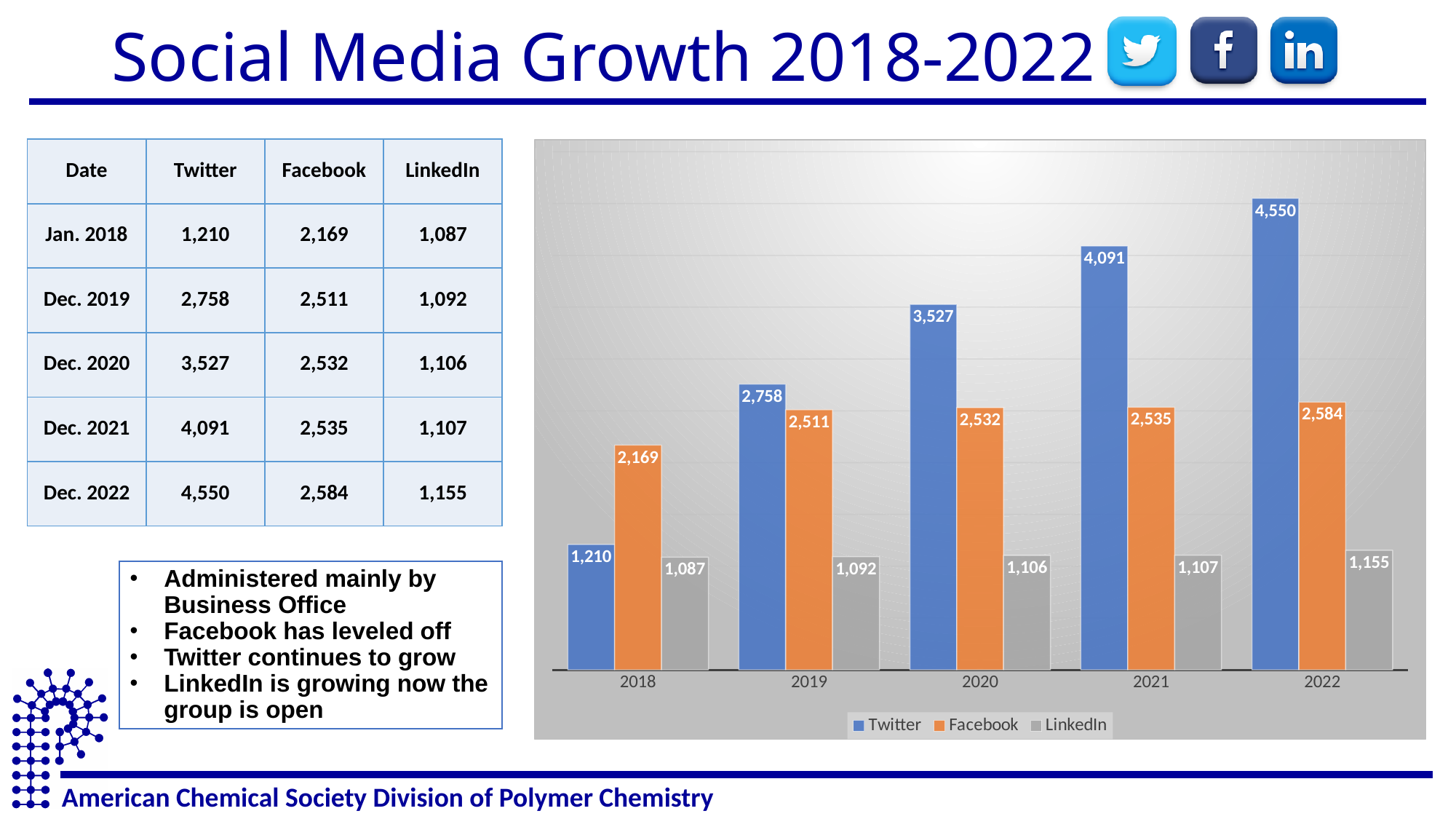
Which is larger in 2018, the Twitter value or the Facebook value? Facebook How many series does the chart legend list? 3 In which year is the LinkedIn value lowest? 2018 What is the Facebook value for 2019 in the chart? 2,511 In which year is the Twitter value highest? 2022 Do the Twitter values rise or fall from 2018 to 2022? Rise What is the difference between the Twitter values for 2022 and 2018? 3,340 What is the LinkedIn value for 2022 in the chart? 1,155 What kind of chart is shown on the slide? Bar chart How many years are shown on the x axis of the chart? 5 What is the Twitter value for 2020 in the chart? 3,527 Which colour represents Facebook in the chart? Orange